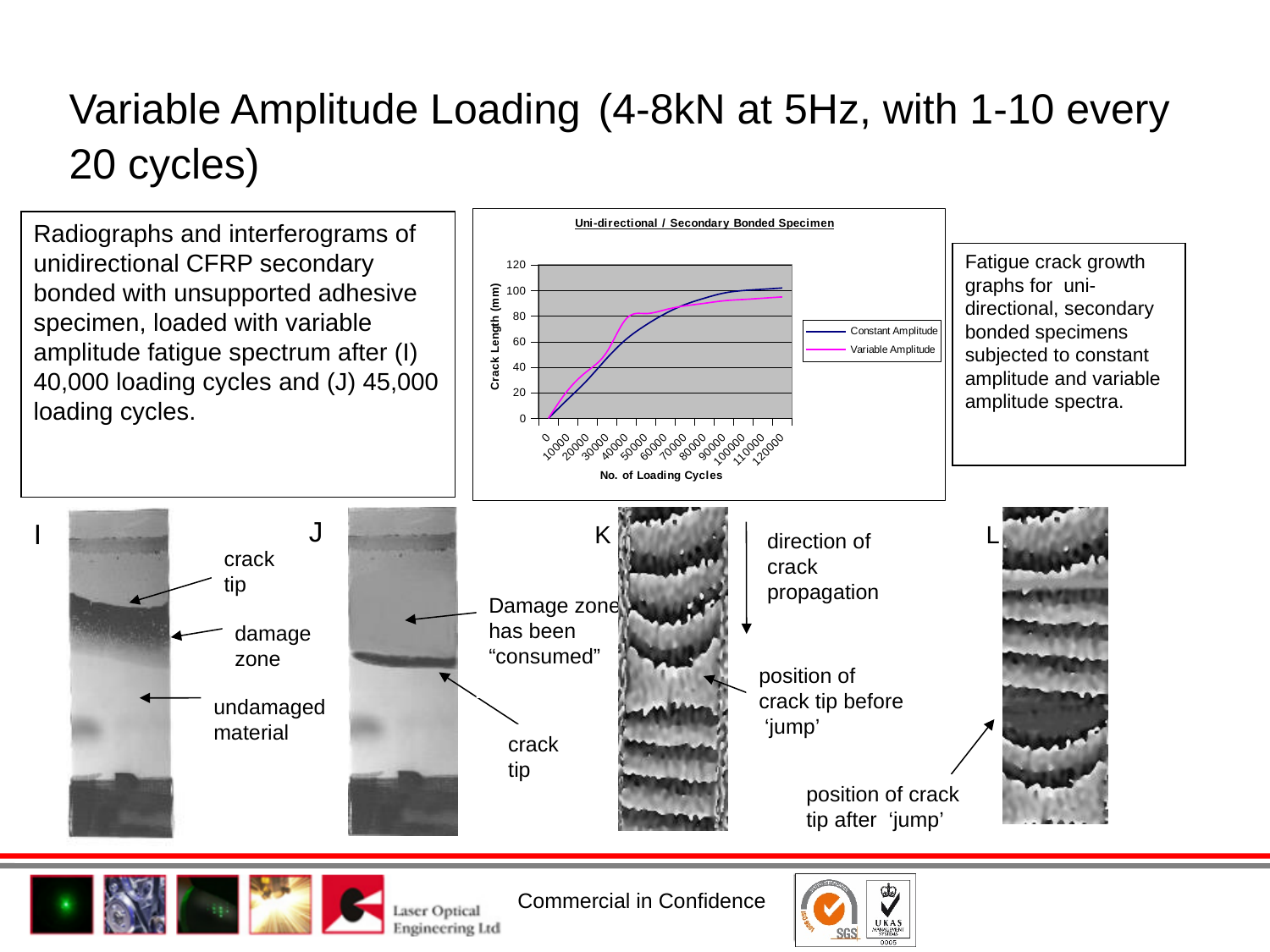
What is the highest value shown on the chart's x axis? 120000 How many series does the chart's legend list? 2 Is the Variable Amplitude crack length at 50000 loading cycles greater or less than 60? greater Does the Constant Amplitude series rise or fall as the number of loading cycles increases? rise At 50000 loading cycles, which series has the greater crack length, Constant Amplitude or Variable Amplitude? Variable Amplitude Is the Constant Amplitude crack length at 50000 loading cycles greater or less than 80? less What kind of chart is shown on the slide? line chart What is the title of the chart? Uni-directional / Secondary Bonded Specimen What is the label of the chart's y axis? Crack Length (mm) Is the Constant Amplitude crack length at 20000 loading cycles greater or less than 40? less At 120000 loading cycles, which series has the greater crack length, Constant Amplitude or Variable Amplitude? Constant Amplitude